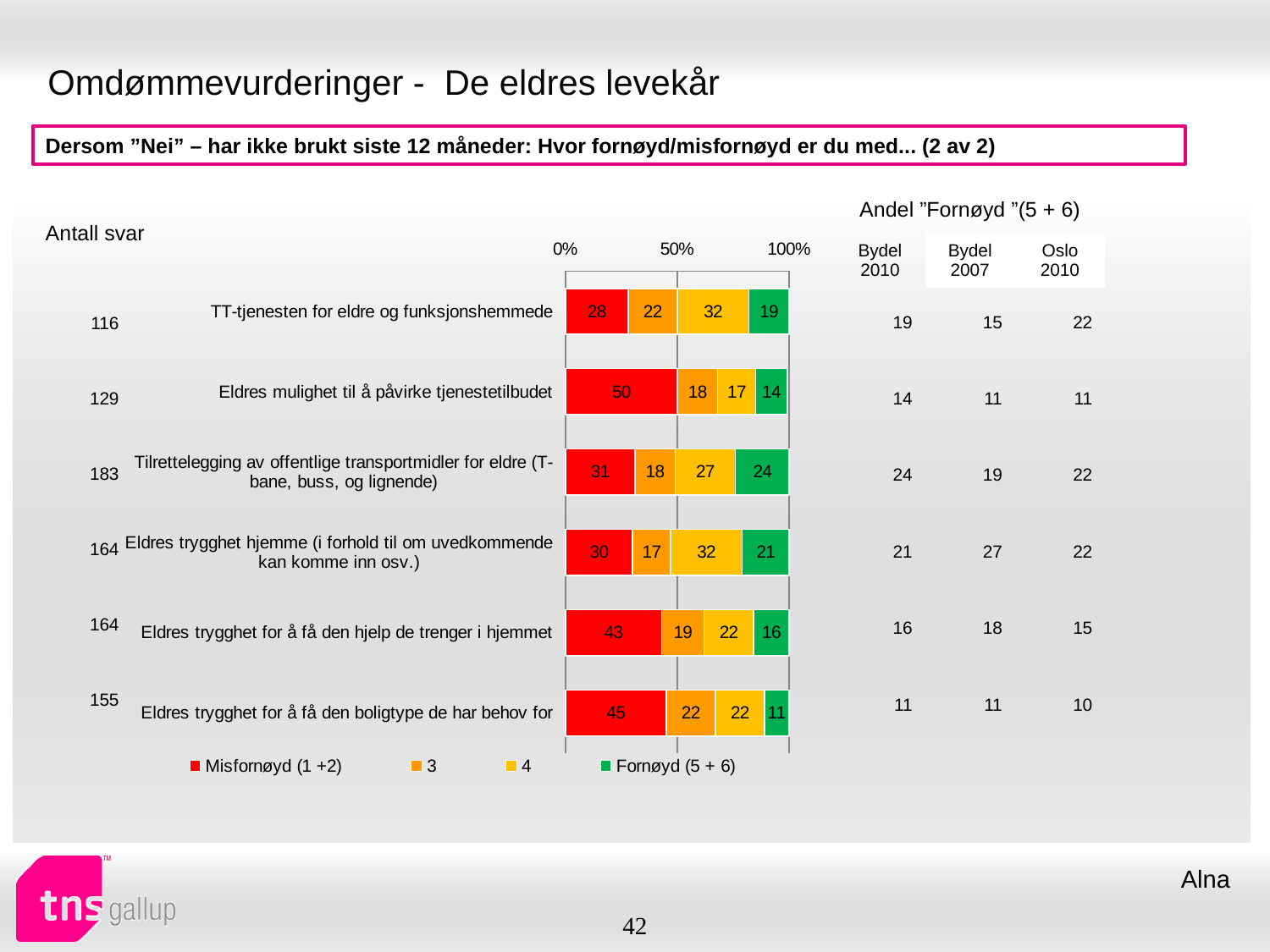
Which category has the lowest Fornøyd (5 + 6) value? Eldres trygghet for å få den boligtype de har behov for What is the value of series '4' for 'Eldres trygghet hjemme (i forhold til om uvedkommende kan komme inn osv.)'? 32 What is the total of the stacked bar for 'Eldres trygghet for å få den hjelp de trenger i hjemmet'? 100 How many categories are shown in the bar chart? 6 Which category has the highest Misfornøyd (1 +2) value? Eldres mulighet til å påvirke tjenestetilbudet What is the Misfornøyd (1 +2) value for 'Eldres mulighet til å påvirke tjenestetilbudet'? 50 Which colour represents Fornøyd (5 + 6) in the chart? Green What is the Fornøyd (5 + 6) value for 'Tilrettelegging av offentlige transportmidler for eldre (T-bane, buss, og lignende)'? 24 Which is larger: the Fornøyd (5 + 6) value for 'TT-tjenesten for eldre og funksjonshemmede' or for 'Eldres trygghet for å få den hjelp de trenger i hjemmet'? TT-tjenesten for eldre og funksjonshemmede How many series does the legend list? 4 What kind of chart is shown on the slide? Stacked bar chart What is the difference between the Misfornøyd (1 +2) values for 'Eldres trygghet for å få den boligtype de har behov for' and 'TT-tjenesten for eldre og funksjonshemmede'? 17